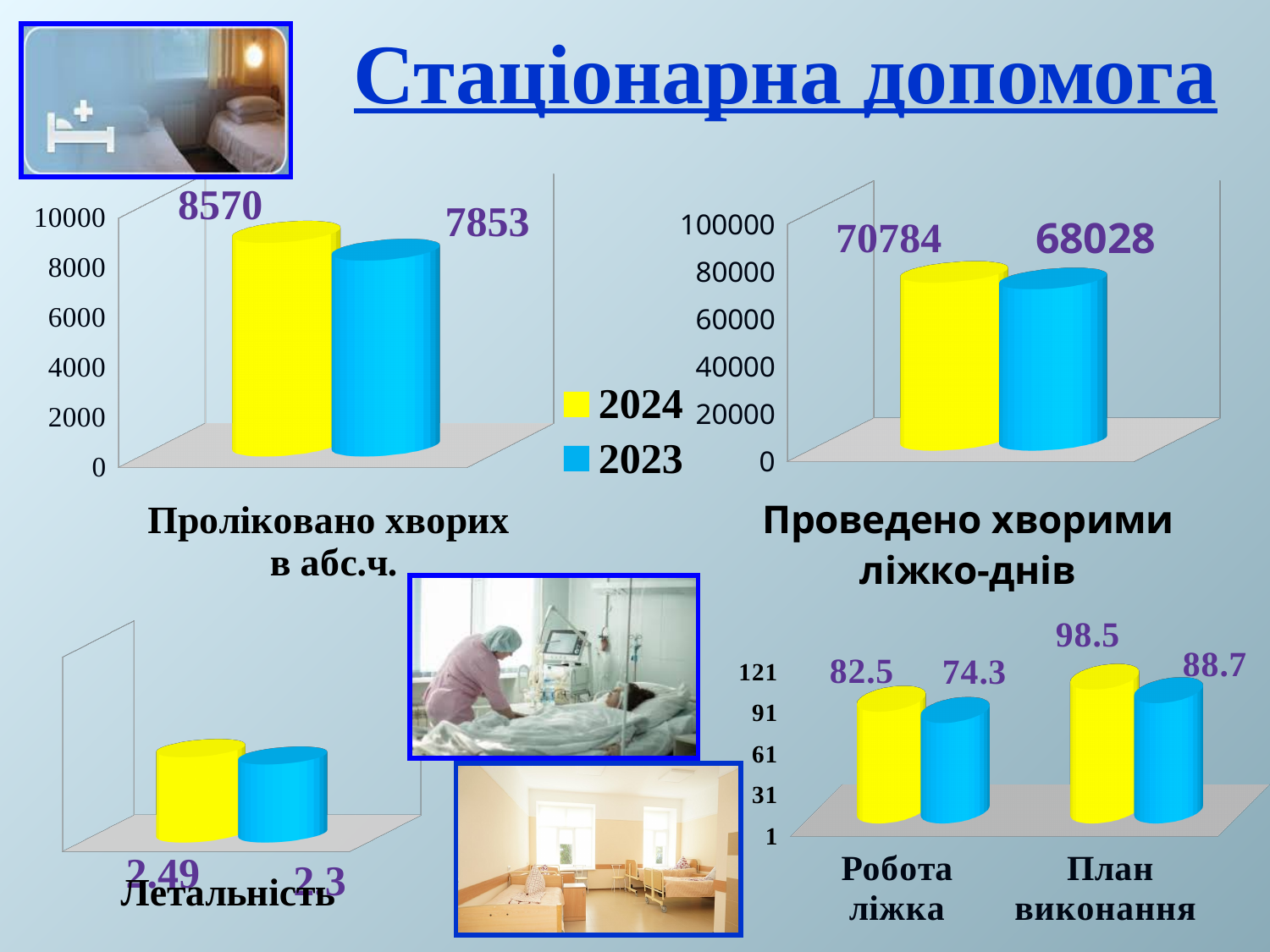
In the bottom-right chart, what is the difference between the 2024 and 2023 values for "План виконання"? 9.8 In the chart titled "Проведено хворими ліжко-днів", which year has the larger value, 2024 or 2023? 2024 How many series does the legend on the slide list? 2 In the bottom-right chart, what is the 2024 value for "Робота ліжка"? 82.5 In the chart titled "Проведено хворими ліжко-днів", what is the value for 2023? 68028 In the chart titled "Летальність", what is the value for 2024? 2.49 In the chart titled "Летальність", what is the value for 2023? 2.3 In the bottom-right chart, what is the 2023 value for "План виконання"? 88.7 In the chart titled "Проліковано хворих в абс.ч.", what is the value for 2023? 7853 In the chart titled "Проліковано хворих в абс.ч.", what is the value for 2024? 8570 In the chart titled "Проведено хворими ліжко-днів", what is the value for 2024? 70784 In the chart titled "Проліковано хворих в абс.ч.", what is the difference between the 2024 and 2023 values? 717